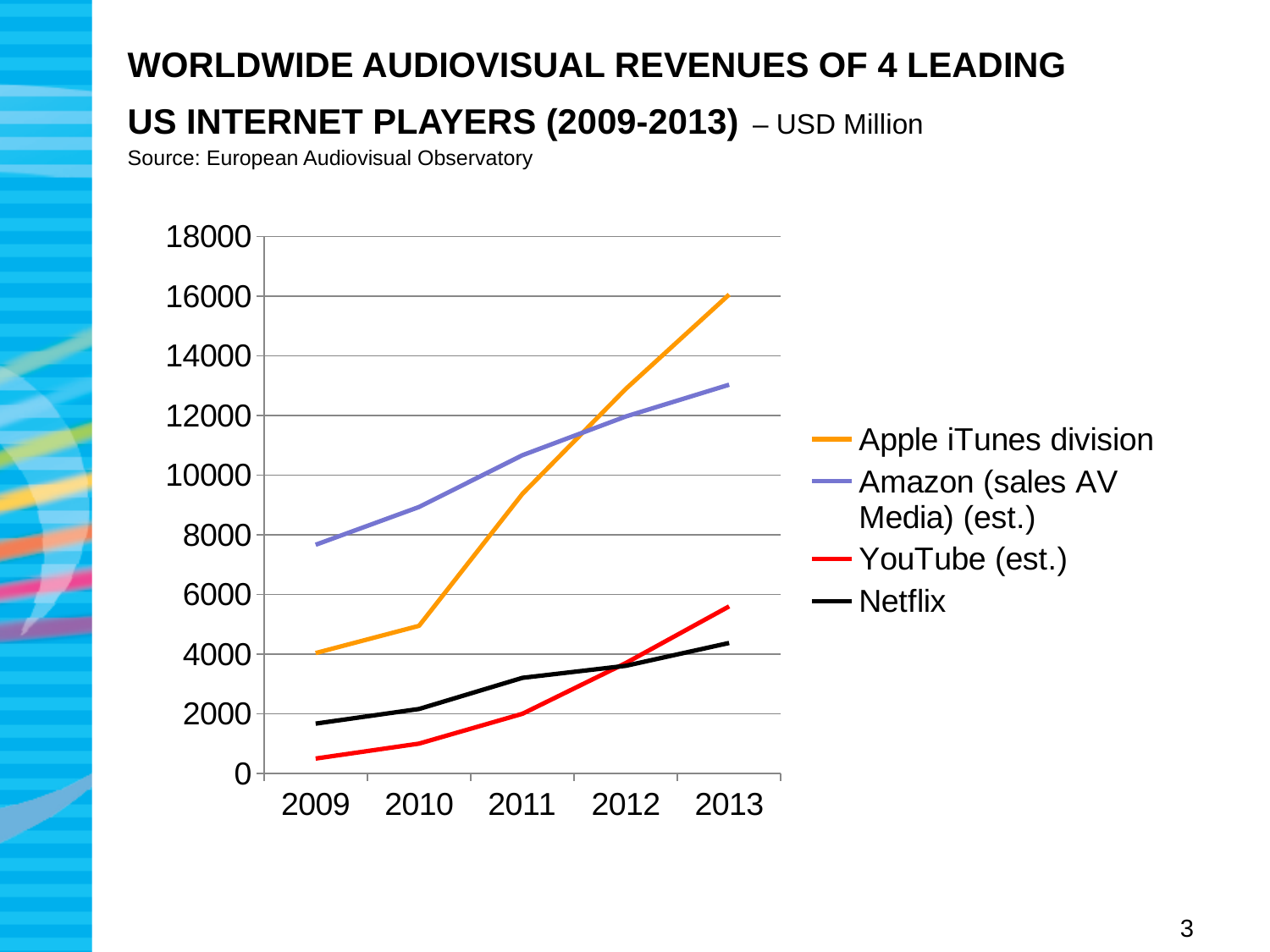
Which series has the highest value in 2013? Apple iTunes division What kind of chart is shown on the slide? line chart In 2010, which is larger: Amazon (sales AV Media) (est.) or Apple iTunes division? Amazon (sales AV Media) (est.) Is the value for YouTube (est.) in 2009 greater or less than 2000? less Which series has the lowest value in 2009? YouTube (est.) Do the values for Apple iTunes division rise or fall from 2009 to 2013? rise Is the value for Apple iTunes division in 2013 greater or less than 14000? greater How many years are plotted along the x axis? 5 What colour is the line for Netflix? black How many series does the legend list? 4 Is the value for Netflix in 2013 greater or less than 4000? greater Which series has the highest value in 2009? Amazon (sales AV Media) (est.)